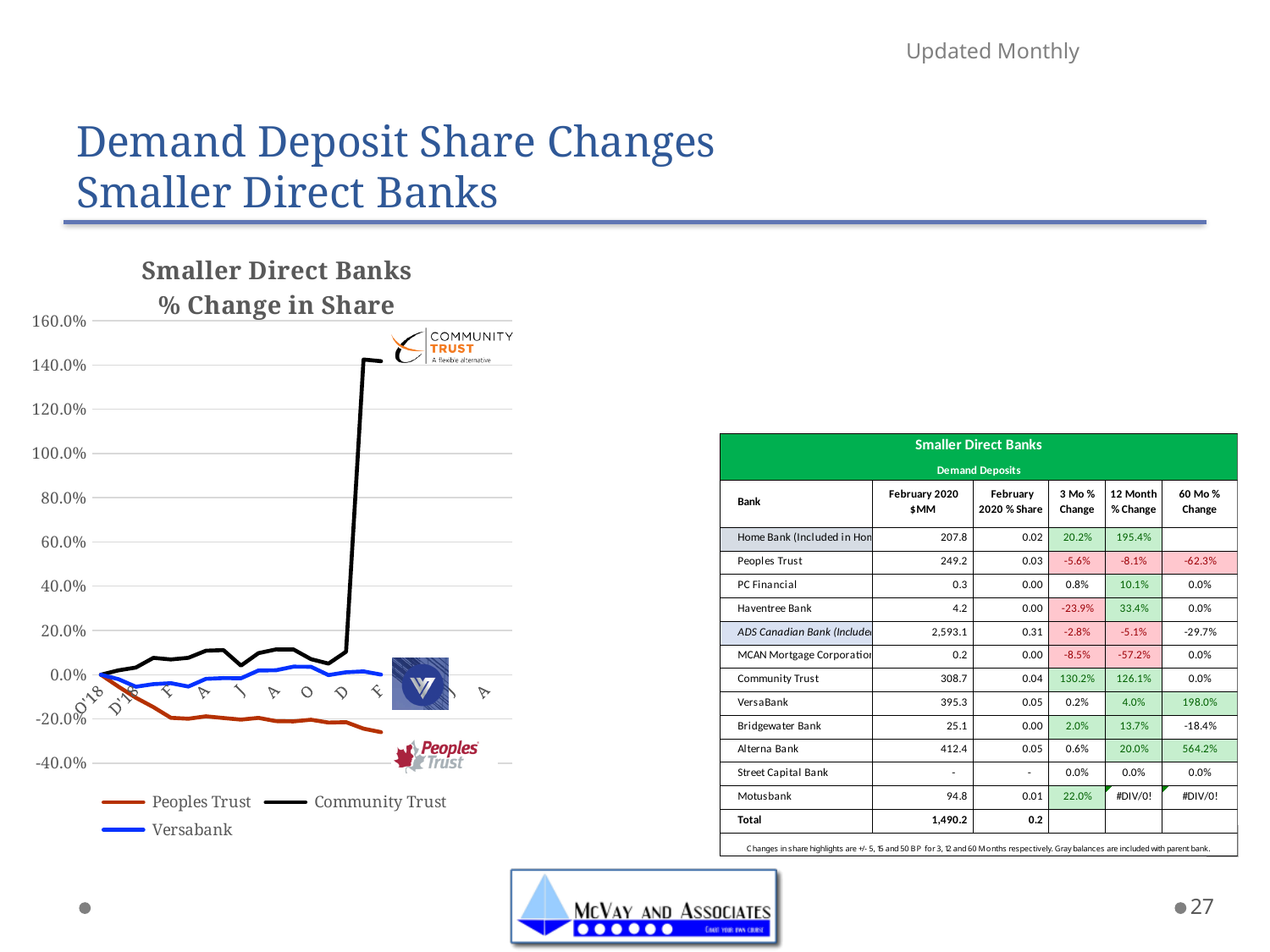
Which series are listed in the chart's legend? Peoples Trust, Community Trust, Versabank At the right end of the chart, which is higher: Versabank or Peoples Trust? Versabank Is the final value for Peoples Trust greater or less than -20.0%? less What colour is the Versabank line in the chart? blue Is the final value for Community Trust greater or less than 120.0%? greater Does the Peoples Trust line generally rise or fall along the x axis? fall At the right end of the chart, which is higher: Community Trust or Peoples Trust? Community Trust What kind of chart is shown on the slide? line chart Is the final value for Versabank greater or less than 20.0%? less Which series has the lowest value at the right end of the chart? Peoples Trust Which series reaches the highest value on the chart? Community Trust How many series does the legend of the chart list? 3